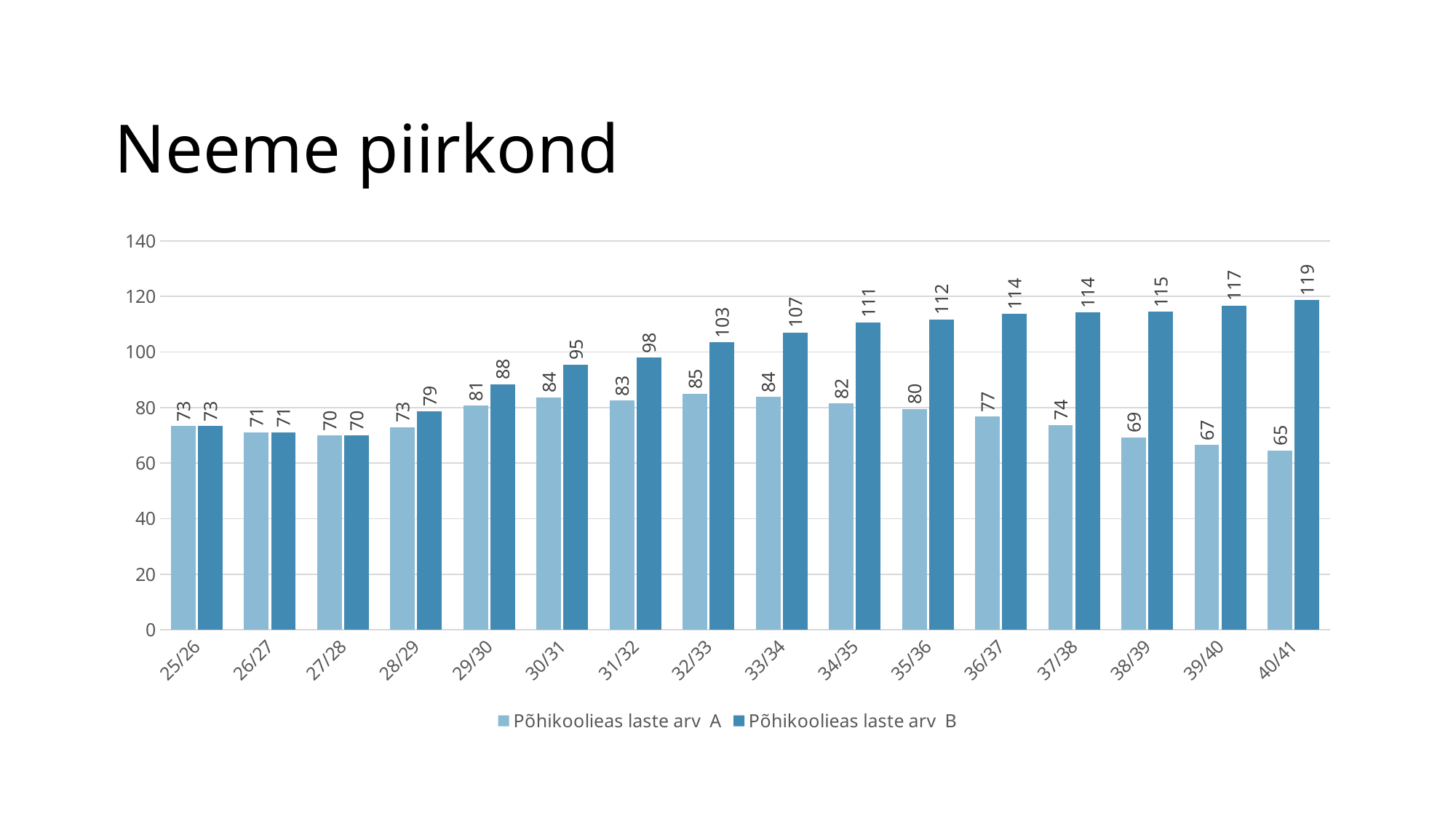
Which is larger for 36/37: Põhikoolieas laste arv A or Põhikoolieas laste arv B? Põhikoolieas laste arv B Is the value of Põhikoolieas laste arv B for 34/35 greater or less than 100? greater What is the value of Põhikoolieas laste arv A for 38/39? 69 How many categories are shown on the x axis? 16 What is the value of Põhikoolieas laste arv B for 32/33? 103 How many series does the legend list? 2 Which category has the lowest value for Põhikoolieas laste arv A? 40/41 Which category has the highest value for Põhikoolieas laste arv B? 40/41 What is the difference between Põhikoolieas laste arv B and Põhikoolieas laste arv A for 40/41? 54 Does Põhikoolieas laste arv B rise or fall from 28/29 to 40/41? rise What is the title of the slide? Neeme piirkond What kind of chart is shown on the slide? bar chart